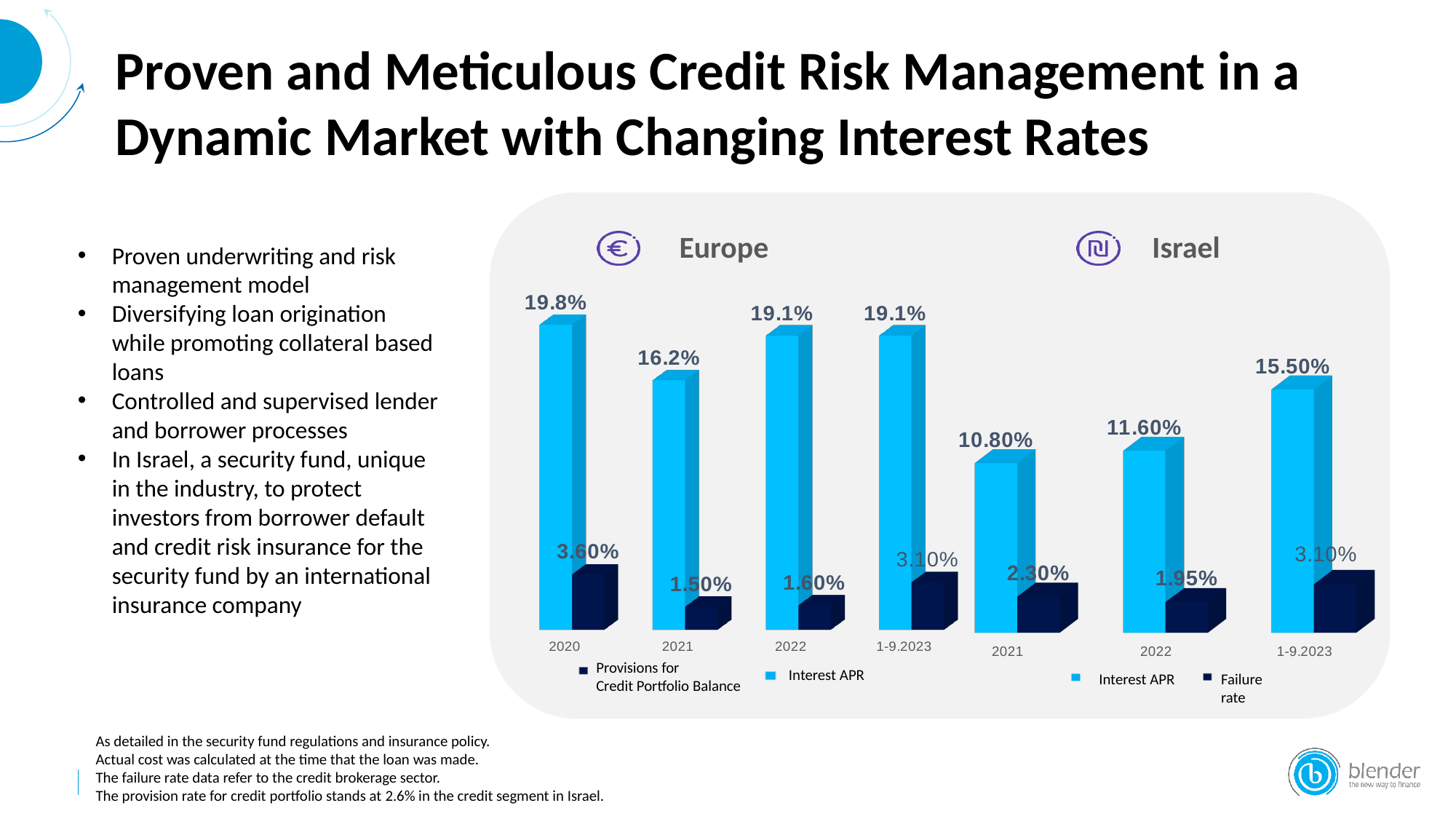
In the Europe chart, which period has the lowest Provisions for Credit Portfolio Balance? 2021 In the Europe chart, what is the Interest APR for 2020? 19.8% In the Europe chart, what is the Provisions for Credit Portfolio Balance value for 2021? 1.50% In the Israel chart, what is the Interest APR for 1-9.2023? 15.50% In the Europe chart, which year has the highest Interest APR? 2020 In the Israel chart, is the Failure rate for 1-9.2023 larger or smaller than the Failure rate for 2021? larger How many series does the legend of the Europe chart list? 2 How many periods are shown on the x axis of the Israel chart? 3 In the Israel chart, which period has the lowest Interest APR? 2021 In the Europe chart, what is the difference between the Interest APR for 2020 and 2021? 3.6% In the Israel chart, does the Interest APR rise or fall from 2021 to 1-9.2023? rise In the Israel chart, what is the Failure rate for 2022? 1.95%